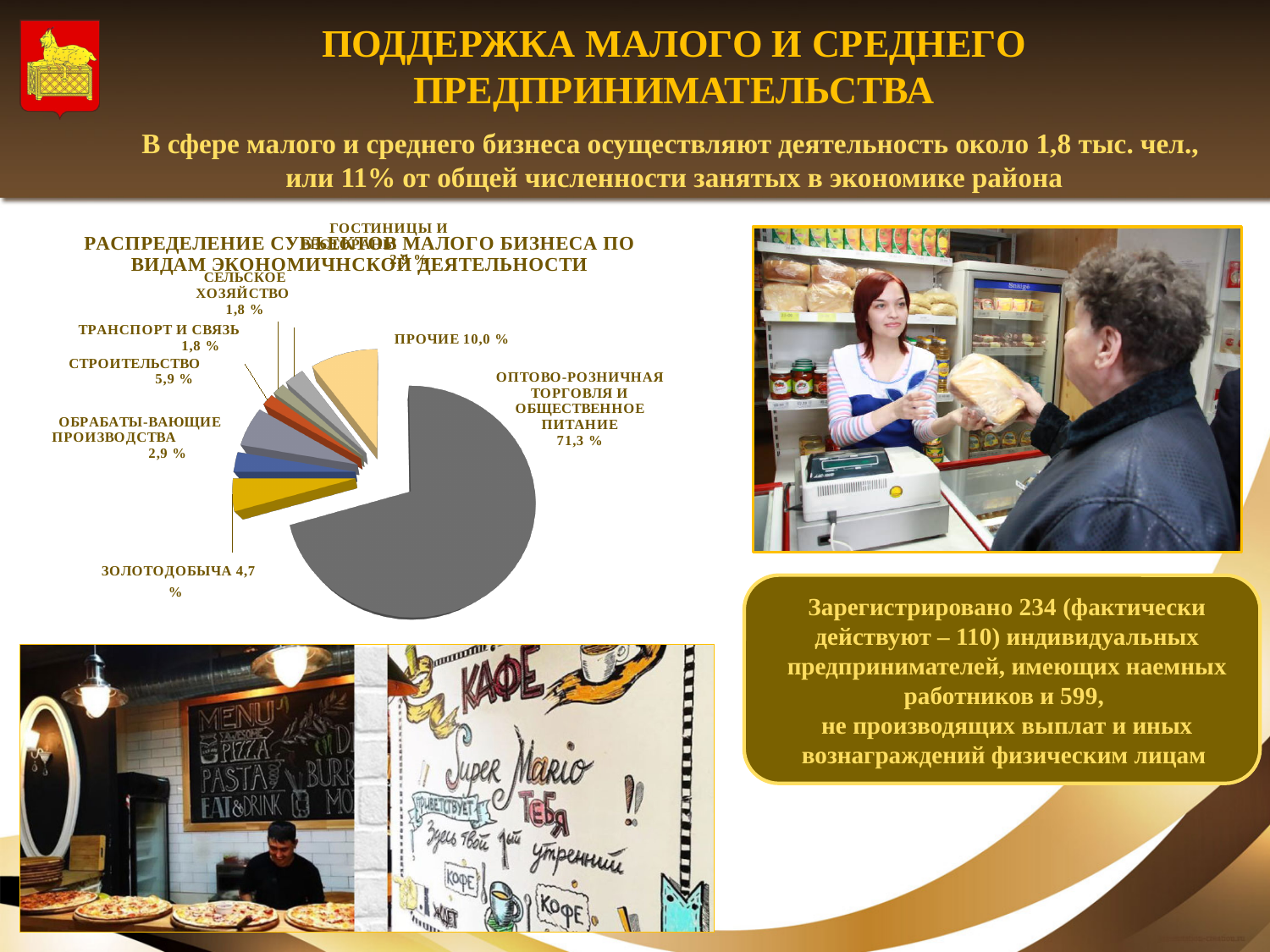
What is the difference in percentage points between ОПТОВО-РОЗНИЧНАЯ ТОРГОВЛЯ И ОБЩЕСТВЕННОЕ ПИТАНИЕ and ПРОЧИЕ? 61,3 % What is the value shown for ОБРАБАТЫВАЮЩИЕ ПРОИЗВОДСТВА (manufacturing)? 2,9 % What is the value shown for ТРАНСПОРТ И СВЯЗЬ (transport and communications)? 1,8 % Which type of economic activity has the largest share in the pie chart? ОПТОВО-РОЗНИЧНАЯ ТОРГОВЛЯ И ОБЩЕСТВЕННОЕ ПИТАНИЕ What share does ПРОЧИЕ (other) account for in the pie chart? 10,0 % What is the value shown for ЗОЛОТОДОБЫЧА (gold mining)? 4,7 % What kind of chart is shown on the slide? pie chart Which is larger: the share for СТРОИТЕЛЬСТВО or for ЗОЛОТОДОБЫЧА? СТРОИТЕЛЬСТВО What is the value shown for СТРОИТЕЛЬСТВО (construction)? 5,9 % What share of small business entities is in wholesale-retail trade and public catering (ОПТОВО-РОЗНИЧНАЯ ТОРГОВЛЯ И ОБЩЕСТВЕННОЕ ПИТАНИЕ)? 71,3 % What is the title of the pie chart? РАСПРЕДЕЛЕНИЕ СУБЪЕКТОВ МАЛОГО БИЗНЕСА ПО ВИДАМ ЭКОНОМИЧНСКОЙ ДЕЯТЕЛЬНОСТИ What is the difference in percentage points between ПРОЧИЕ and СТРОИТЕЛЬСТВО? 4,1 %